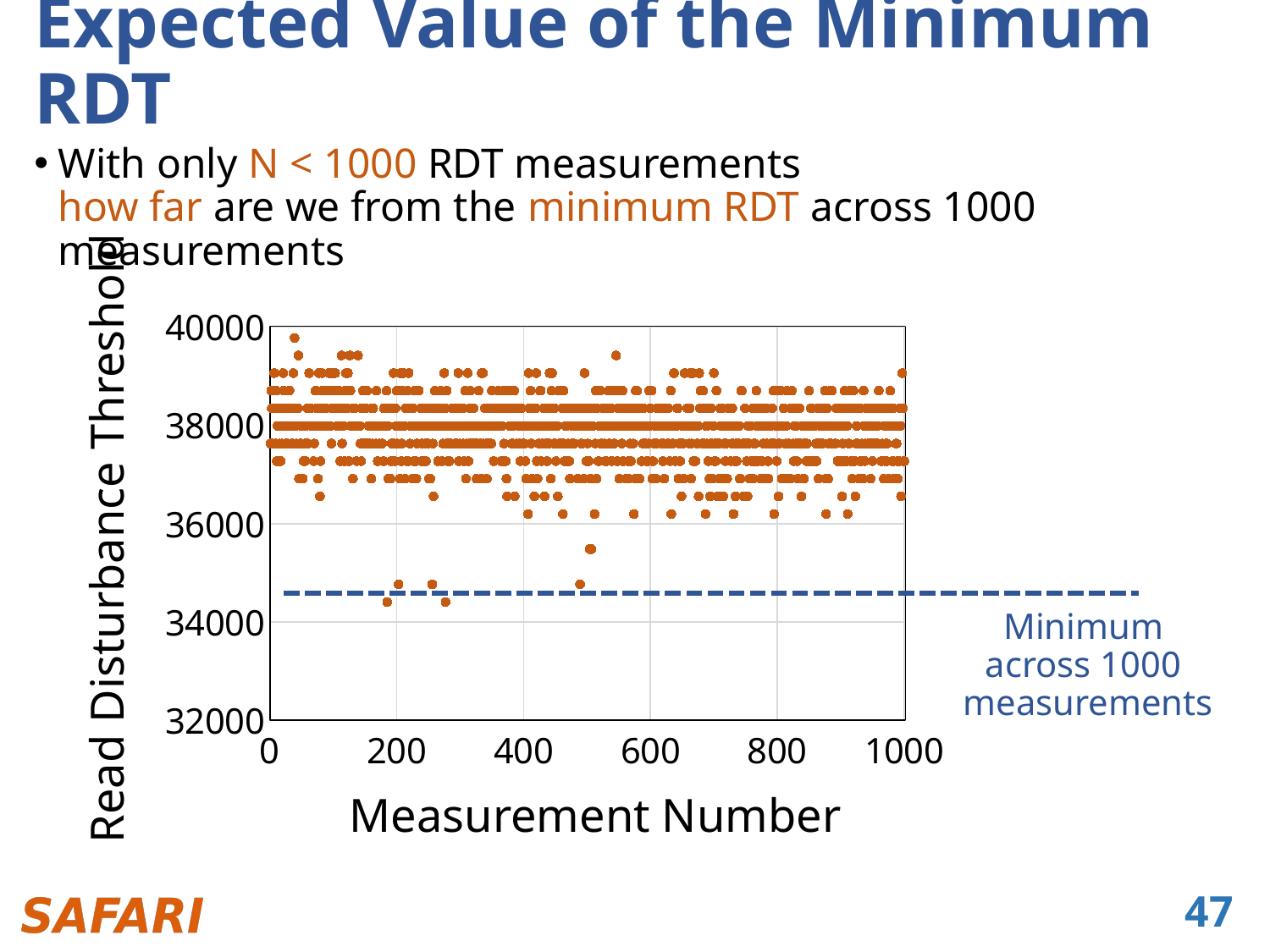
What is the label of the x axis of the chart? Measurement Number Is the highest plotted Read Disturbance Threshold value greater or less than 38000? greater Do the plotted Read Disturbance Threshold values show a clear rising or falling trend as the Measurement Number increases, or do they stay roughly flat? roughly flat Is the lowest plotted Read Disturbance Threshold value greater or less than 36000? less What is the highest value shown on the y axis of the chart? 40000 Is the dashed horizontal line (Minimum across 1000 measurements) greater or less than 34000? greater What is the highest value shown on the x axis of the chart? 1000 What kind of chart is shown on the slide? scatter plot